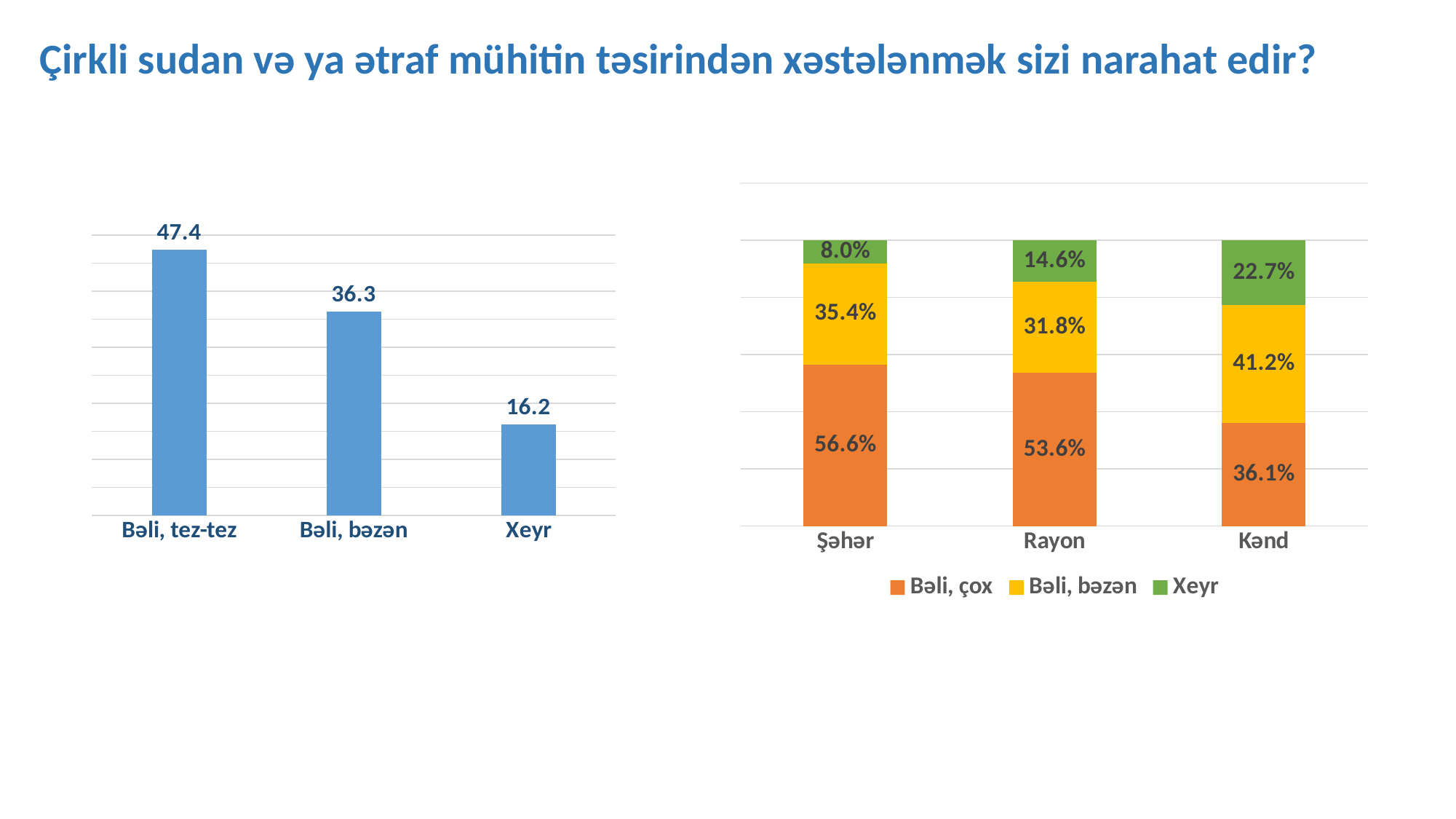
In the right chart, what is the value of "Bəli, çox" for Kənd? 36.1% What kind of chart is the chart on the right? Stacked bar chart In the left chart, what is the difference between the values for "Bəli, tez-tez" and "Xeyr"? 31.2 In the left chart, which category has the lowest value? Xeyr In the left chart, what is the value for "Bəli, tez-tez"? 47.4 In the right chart, what is the value of "Xeyr" for Rayon? 14.6% In the right chart, which category has the highest "Xeyr" value? Kənd In the left chart, how many categories are shown? 3 In the right chart, is the "Bəli, bəzən" value larger for Şəhər or for Kənd? Kənd How many series does the legend of the right chart list? 3 In the right chart, what is the difference between the "Bəli, çox" values for Şəhər and Rayon? 3.0% In the right chart, what colour represents the "Xeyr" series? Green